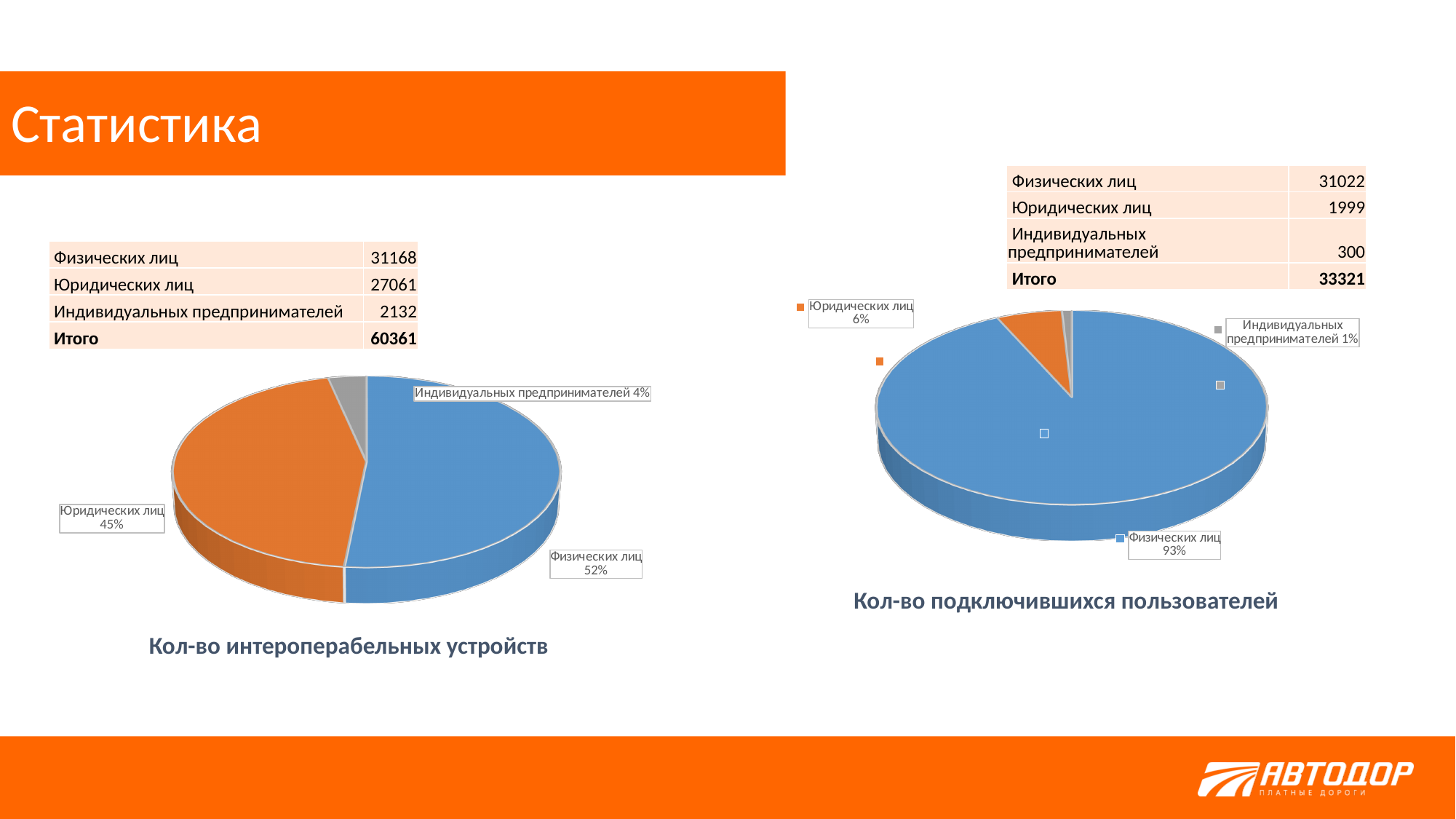
In the left chart 'Кол-во интероперабельных устройств', which category has the smallest slice? Индивидуальных предпринимателей In the left chart 'Кол-во интероперабельных устройств', what share of the pie is 'Индивидуальных предпринимателей'? 4% In the right chart 'Кол-во подключившихся пользователей', what is the difference in percentage points between the 'Физических лиц' and 'Юридических лиц' slices? 87 In the right chart 'Кол-во подключившихся пользователей', what share of the pie is 'Физических лиц'? 93% In the left chart 'Кол-во интероперабельных устройств', what share of the pie is 'Юридических лиц'? 45% What kind of chart is the left chart 'Кол-во интероперабельных устройств'? Pie chart In the left chart 'Кол-во интероперабельных устройств', which category has the largest slice? Физических лиц In the left chart 'Кол-во интероперабельных устройств', how many slices does the pie have? 3 In the right chart 'Кол-во подключившихся пользователей', which category has the largest slice? Физических лиц